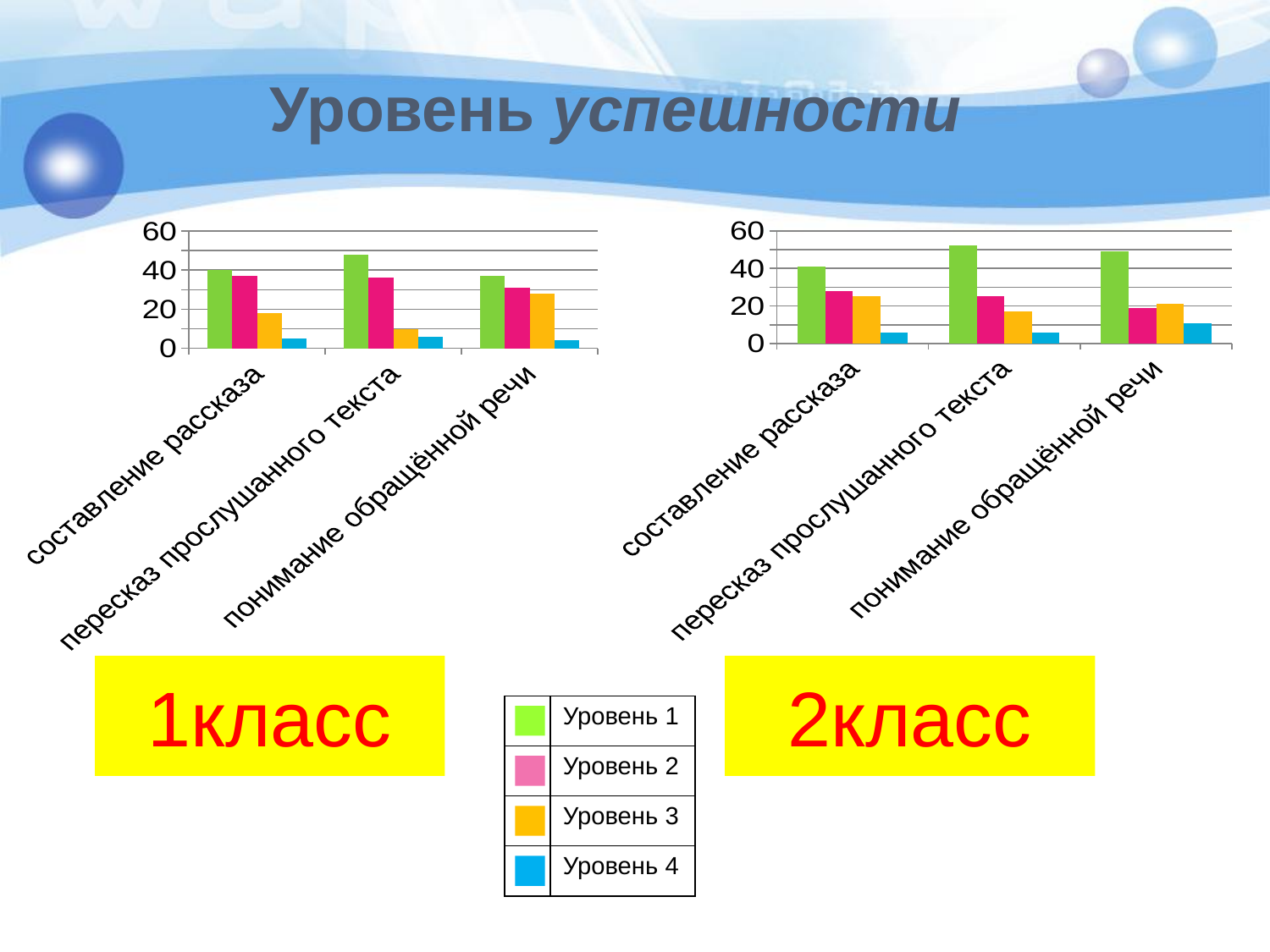
In the 2класс chart, for пересказ прослушанного текста, which is larger: Уровень 2 or Уровень 3? Уровень 2 In the 1класс chart, is the Уровень 3 value for пересказ прослушанного текста greater or less than 20? less What colour represents Уровень 4 in the legend? blue In the 1класс chart, which series has the lowest bar in every category? Уровень 4 In the 2класс chart, is the Уровень 1 value for понимание обращённой речи greater or less than 40? greater In the 2класс chart, which category has the lowest Уровень 1 bar? составление рассказа What kind of chart is the 1класс chart on the left? bar chart In the 1класс chart, is the Уровень 1 value for пересказ прослушанного текста greater or less than 40? greater What is the title of the slide above the charts? Уровень успешности How many series does the legend list? 4 How many categories are shown on the x axis of the 1класс chart? 3 In the 1класс chart, which category has the highest Уровень 1 bar? пересказ прослушанного текста